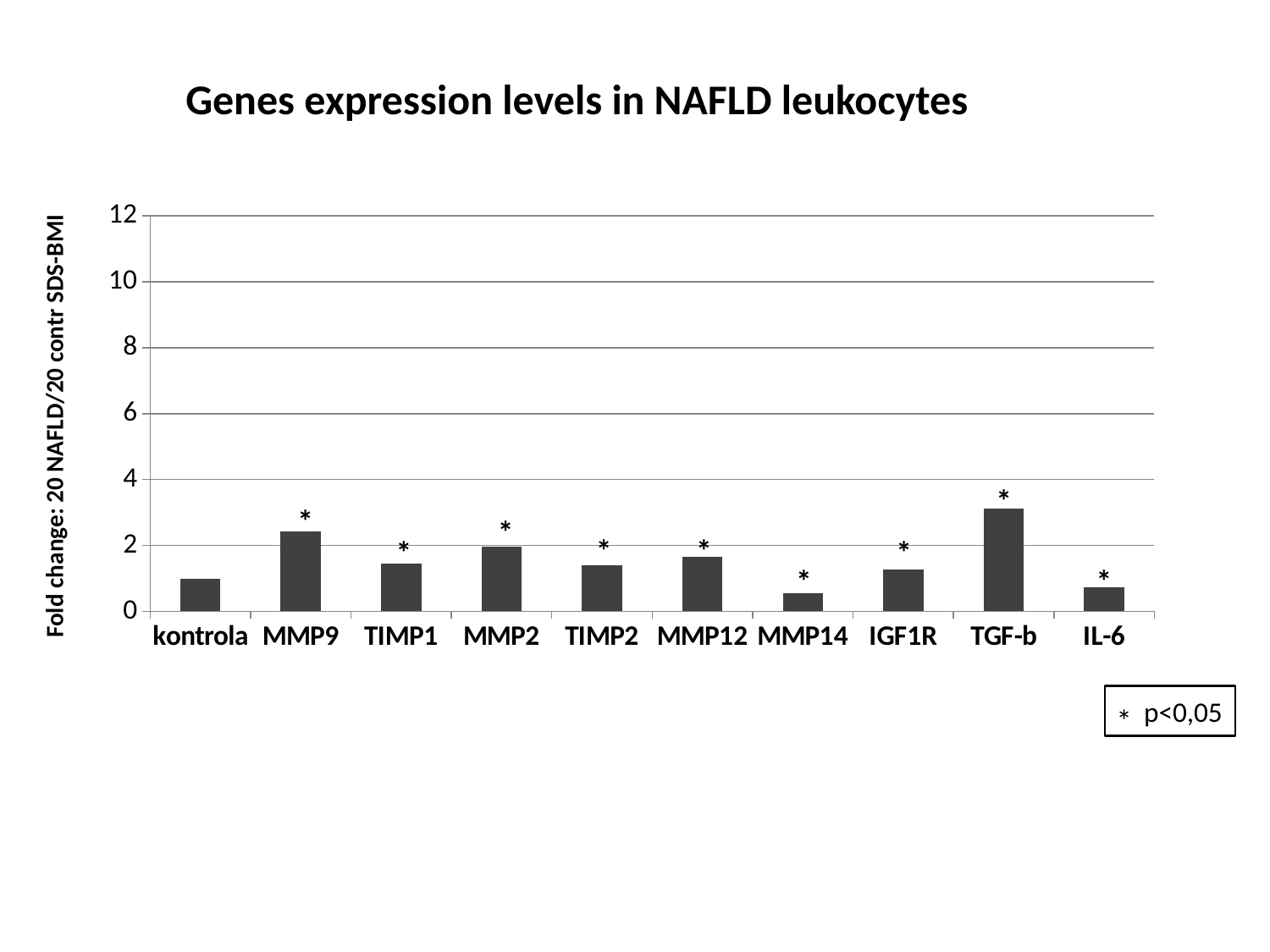
Is the value for MMP9 greater or less than 2? greater What is the title of the chart? Genes expression levels in NAFLD leukocytes Is the value for IL-6 greater or less than 2? less What does the asterisk above the bars indicate, according to the slide? p<0,05 Which has the larger value, TGF-b or MMP9? TGF-b How many categories are shown on the x axis of the chart? 10 Which category has the highest bar in the chart? TGF-b Which category has the lowest bar in the chart? MMP14 Which has the larger value, IGF1R or MMP2? MMP2 What kind of chart is shown on the slide? bar chart Is the value for TIMP1 greater or less than 2? less